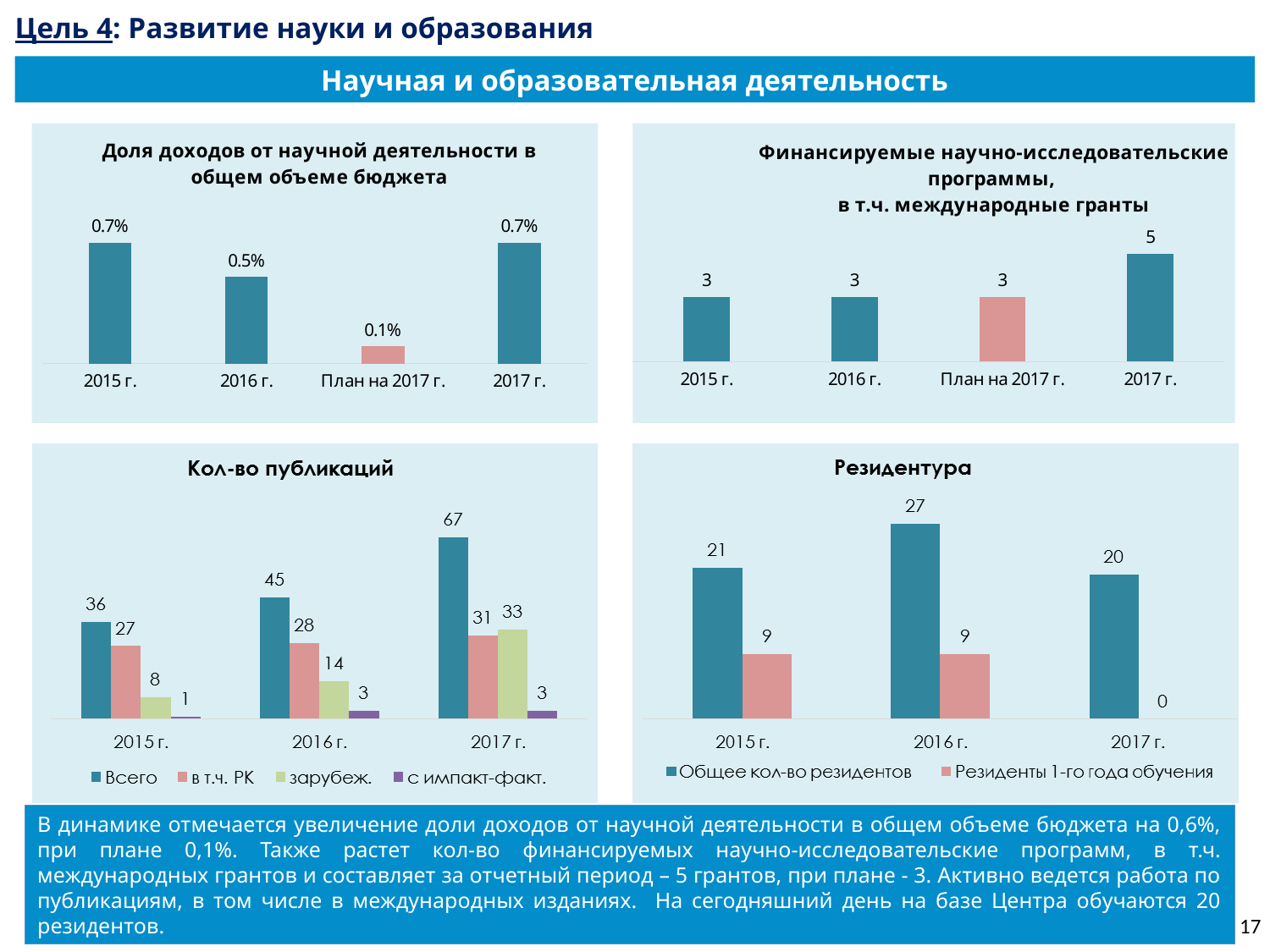
In the chart 'Кол-во публикаций', how many series does the legend list? 4 In the chart 'Резидентура', what is the value of 'Общее кол-во резидентов' for 2016 г.? 27 In the chart 'Доля доходов от научной деятельности в общем объеме бюджета', what is the value for 2016 г.? 0.5% In the chart 'Финансируемые научно-исследовательские программы, в т.ч. международные гранты', how many categories are shown on the x axis? 4 In the chart 'Кол-во публикаций', what is the value of 'Всего' for 2017 г.? 67 What kind of chart is 'Резидентура'? bar chart In the chart 'Кол-во публикаций', what is the value of 'зарубеж.' for 2016 г.? 14 In the chart 'Доля доходов от научной деятельности в общем объеме бюджета', which category has the lowest value? План на 2017 г. In the chart 'Резидентура', what is the difference between 'Общее кол-во резидентов' and 'Резиденты 1-го года обучения' for 2015 г.? 12 In the chart 'Финансируемые научно-исследовательские программы, в т.ч. международные гранты', what is the value for 2017 г.? 5 In the chart 'Финансируемые научно-исследовательские программы, в т.ч. международные гранты', what is the difference between 2017 г. and План на 2017 г.? 2 In the chart 'Кол-во публикаций', does the 'Всего' series rise or fall from 2015 г. to 2017 г.? rise